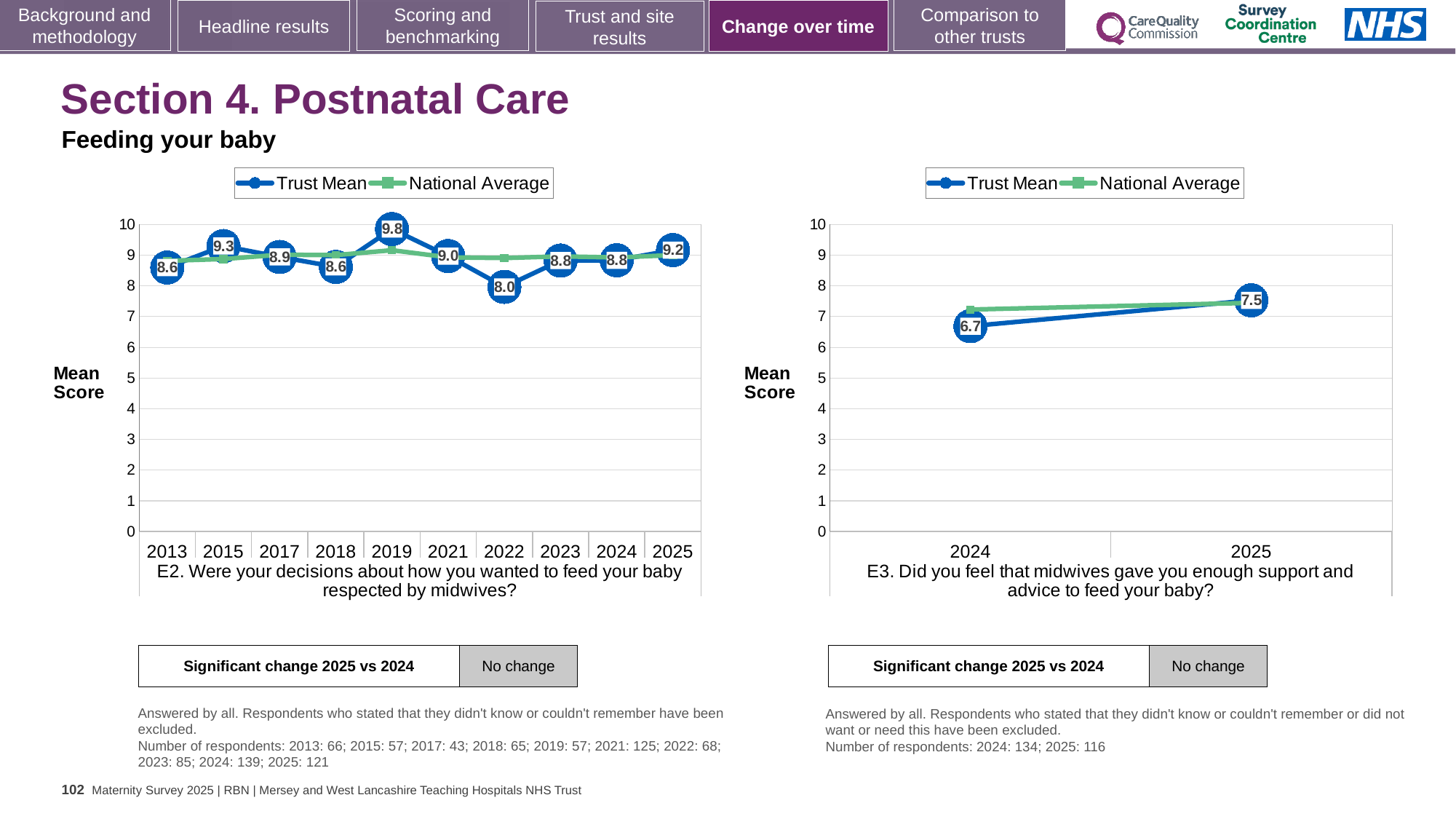
In the E2 chart (left), which year has the lowest Trust Mean? 2022 In the E3 chart (right), does the Trust Mean rise or fall from 2024 to 2025? rise How many series does the legend of the E2 chart (left) list? 2 In the E2 chart (left), what is the difference between the Trust Mean in 2025 and in 2024? 0.4 In the E3 chart (right), what is the Trust Mean for 2025? 7.5 In the E3 chart (right), is the National Average for 2024 greater or less than 7? greater What kind of chart is the E3 chart (right)? line chart In the E2 chart (left), what is the Trust Mean for 2019? 9.8 In the E3 chart (right), what is the Trust Mean for 2024? 6.7 In the E2 chart (left), how many years are shown on the x axis? 10 In the E2 chart (left), which year has the highest Trust Mean? 2019 In the E2 chart (left), what is the Trust Mean for 2022? 8.0